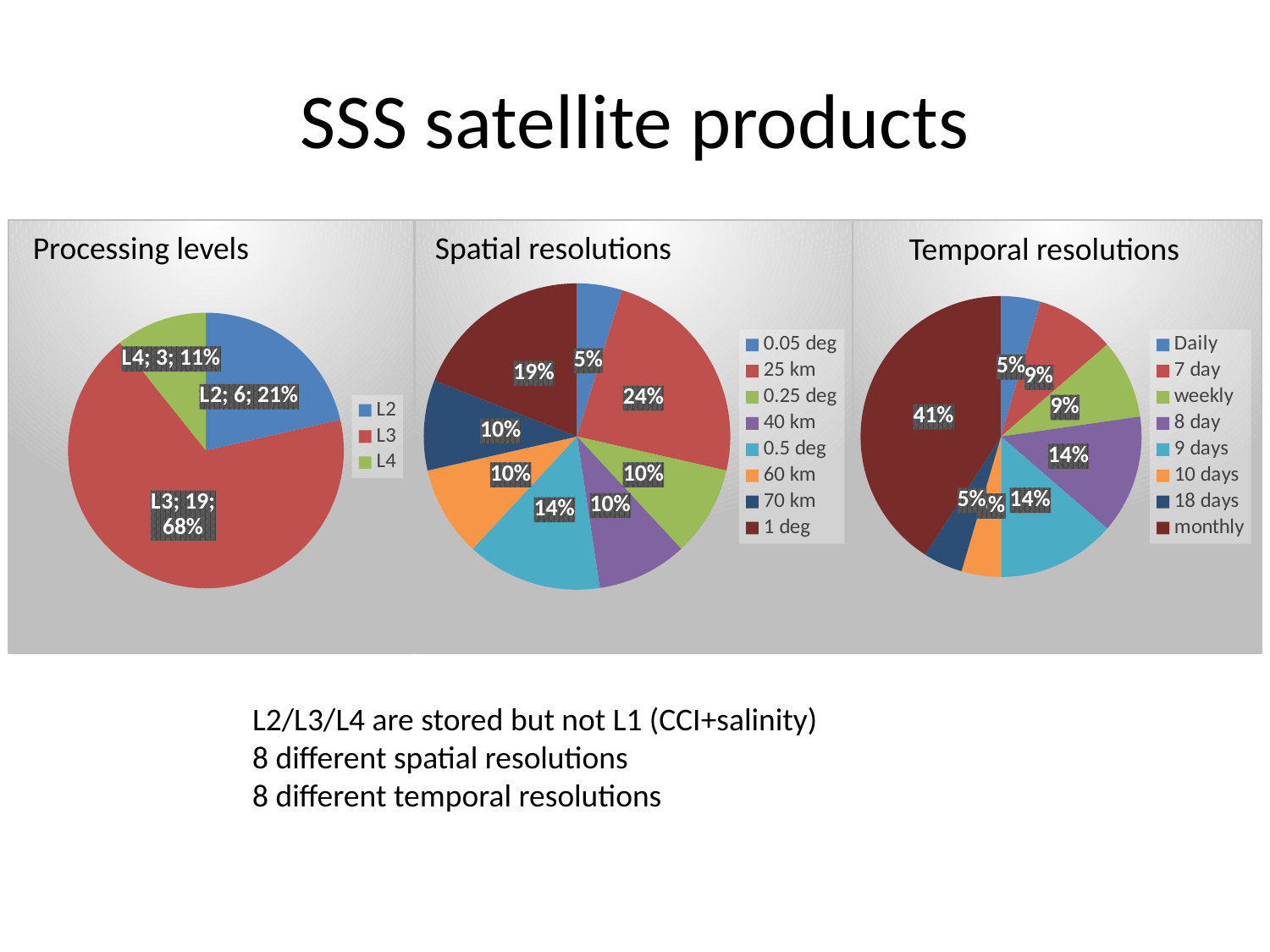
In the Spatial resolutions chart, which resolution has the largest share? 25 km In the Processing levels chart, which processing level has the smallest share? L4 In the Temporal resolutions chart, which is larger, the share for 8 day or the share for 7 day? 8 day How many entries does the legend of the Spatial resolutions chart list? 8 In the Spatial resolutions chart, what share of products has a 25 km resolution? 24% In the Processing levels chart, what share of products is L3? 68% In the Spatial resolutions chart, which resolution has the smallest share? 0.05 deg In the Temporal resolutions chart, what share of products is monthly? 41% In the Processing levels chart, what is the difference in percentage points between the L2 and L4 shares? 10 What kind of chart is the Temporal resolutions chart? Pie chart In the Processing levels chart, how many products are L2? 6